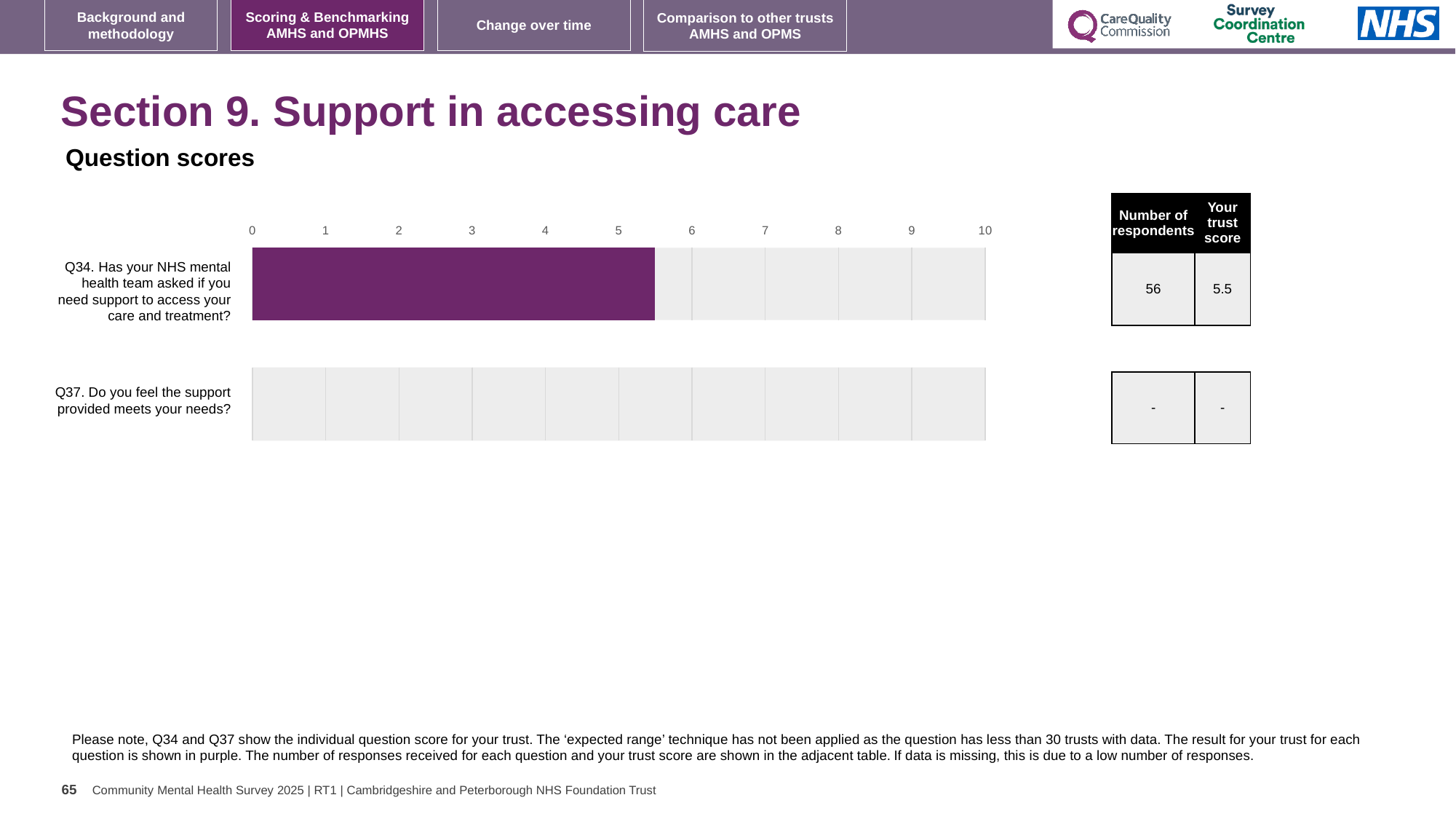
What is the trust score shown for Q34 (Has your NHS mental health team asked if you need support to access your care and treatment?)? 5.5 Is the bar for Q34 greater or less than 5 on the axis? greater How many respondents are listed for Q34 in the adjacent table? 56 What colour is the bar for Q34? Purple What is the highest value shown on the chart's axis? 10 Which question has a bar plotted on the chart? Q34 What kind of chart is shown on the slide? Bar chart What trust score is shown for Q37 (Do you feel the support provided meets your needs?)? - How many questions are plotted on the chart? 2 Is the bar for Q34 greater or less than 6 on the axis? less